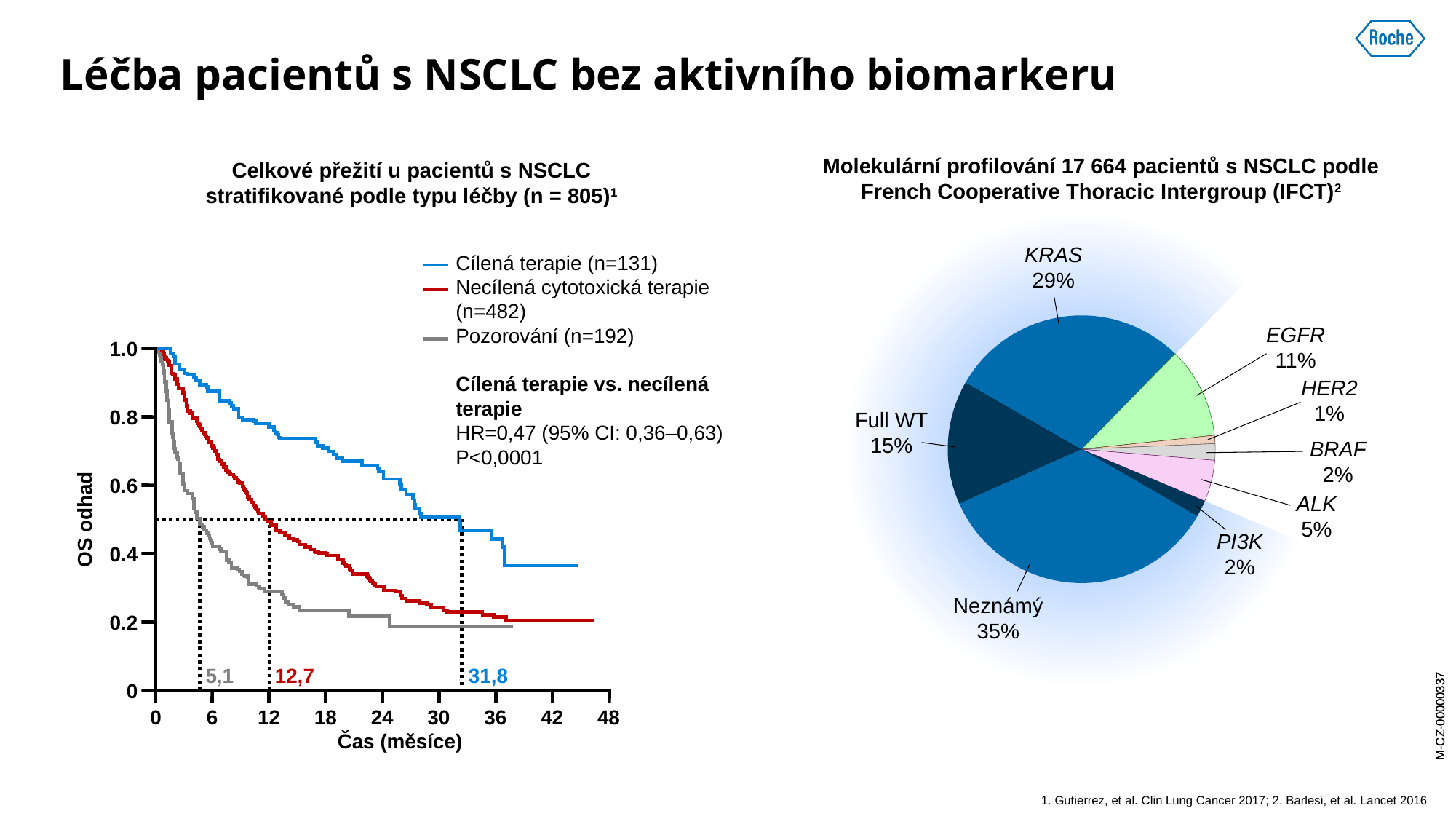
In the pie chart on the right, how many slices (categories) are shown? 8 In the survival chart on the left, do the curves rise or fall as time increases along the x axis? Fall In the survival chart on the left, what is the difference between the marked median times for Cílená terapie (31,8) and Necílená cytotoxická terapie (12,7)? 19,1 What kind of chart is the survival chart on the left? Line chart In the pie chart on the right, which category has the largest slice? Neznámý In the pie chart on the right, which category has the smallest slice? HER2 In the pie chart on the right, what percentage is labelled Full WT? 15% In the pie chart on the right, what is the difference in percentage points between the KRAS and EGFR slices? 18% In the pie chart on the right, what share of patients is labelled KRAS? 29% In the survival chart on the left, how many series does the legend list? 3 In the pie chart on the right, which slice is larger, ALK or BRAF? ALK In the survival chart on the left, what median time (months) is marked for Cílená terapie? 31,8